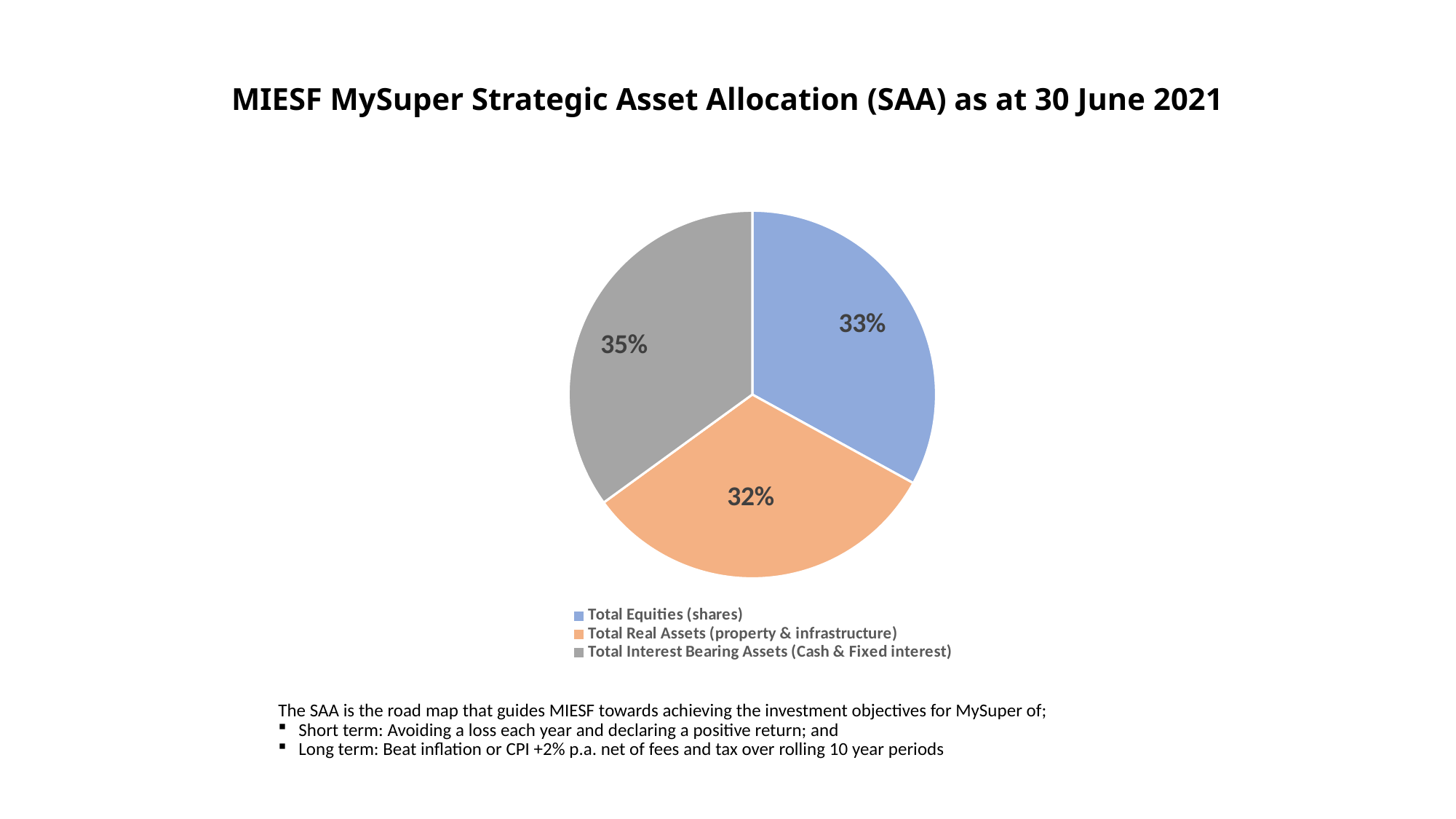
How many categories does the pie chart show? 3 Which category has the smallest slice of the pie? Total Real Assets (property & infrastructure) What is the title of the chart? MIESF MySuper Strategic Asset Allocation (SAA) as at 30 June 2021 What kind of chart is shown on the slide? Pie chart What is the difference in percentage points between Total Interest Bearing Assets and Total Real Assets? 3 percentage points What is the combined share of Total Equities and Total Real Assets? 65% What share of the pie is Total Equities (shares)? 33% Which colour represents Total Real Assets (property & infrastructure) in the pie chart? Orange What is the difference in percentage points between Total Interest Bearing Assets and Total Equities? 2 percentage points Which category has the largest slice of the pie? Total Interest Bearing Assets (Cash & Fixed interest) What share of the pie is Total Real Assets (property & infrastructure)? 32% What share of the pie is Total Interest Bearing Assets (Cash & Fixed interest)? 35%